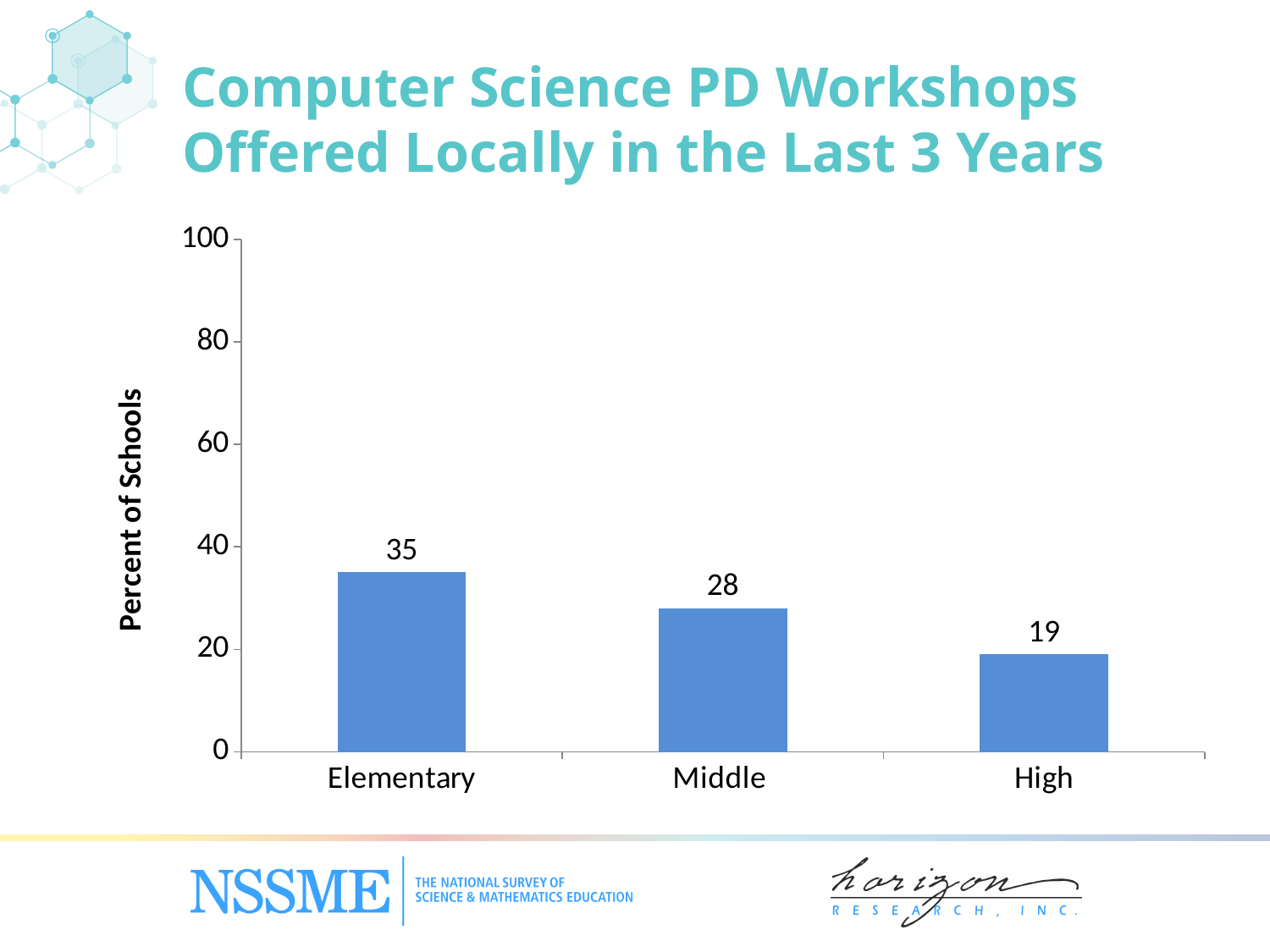
What percent of elementary schools had computer science PD workshops offered locally in the last 3 years? 35 Which school level has the lowest percent of schools? High Do the values rise or fall from Elementary to High along the x axis? Fall What is the difference between the values for Elementary and Middle schools? 7 What is the value shown for High schools? 19 Which is larger, the value for Middle or the value for High? Middle Is the value for Middle schools greater or less than 40? less What kind of chart is shown on the slide? Bar chart How many school levels are shown on the chart? 3 What is the value shown for Middle schools? 28 Which school level has the highest percent of schools? Elementary What is the difference between the values for Elementary and High schools? 16